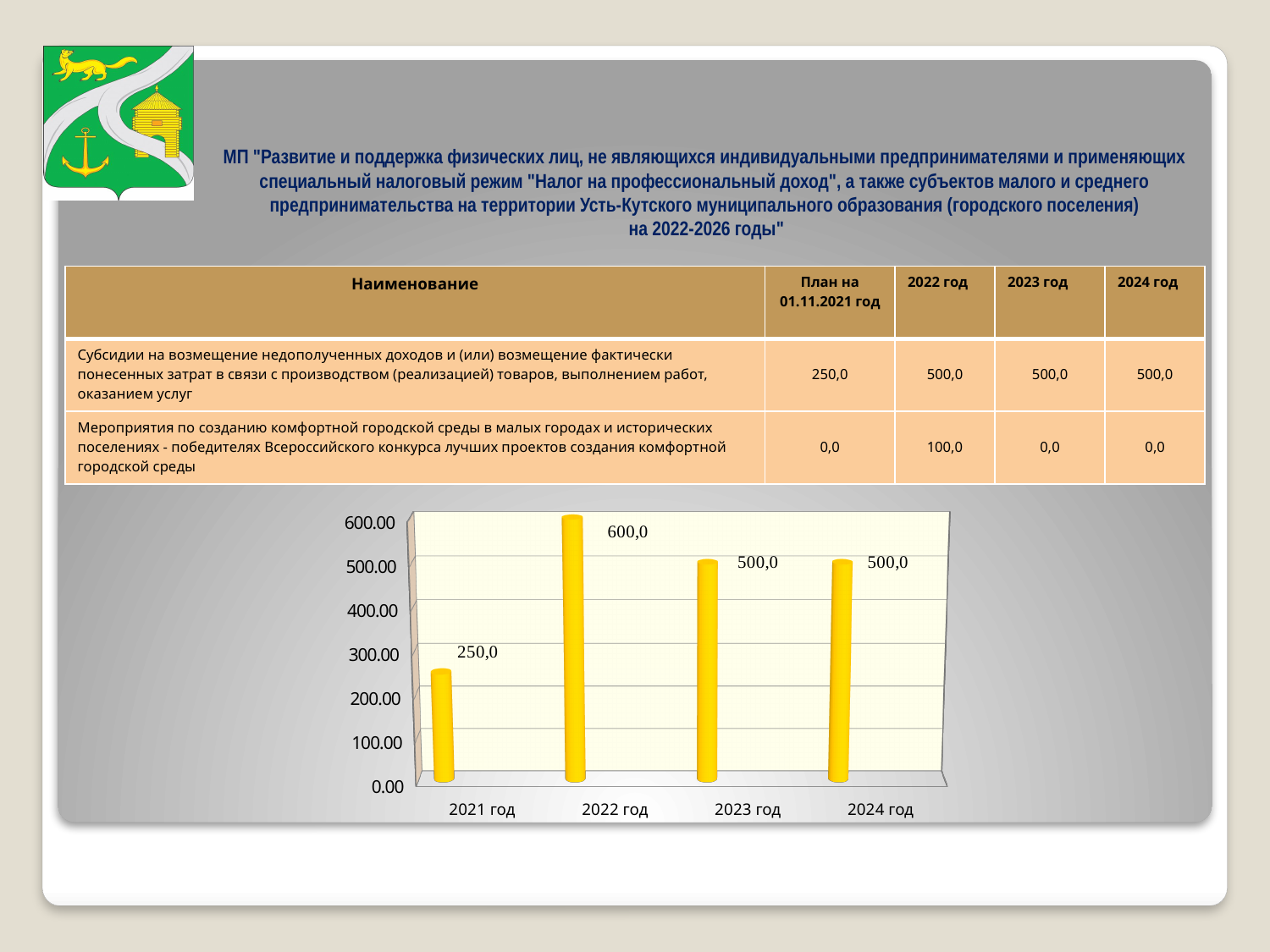
Which year has the highest value? 2022 год What is the difference between the values for 2022 год and 2021 год? 350,0 What is the value for 2024 год? 500,0 Which is larger, the value for 2021 год or the value for 2023 год? 2023 год What is the value for 2023 год? 500,0 What is the value for 2022 год? 600,0 Which year has the lowest value? 2021 год What is the difference between the values for 2022 год and 2023 год? 100,0 What kind of chart is shown on the slide? bar chart Is the value for 2021 год greater or less than 300.00? less How many years are shown on the x axis of the chart? 4 What is the value for 2021 год? 250,0